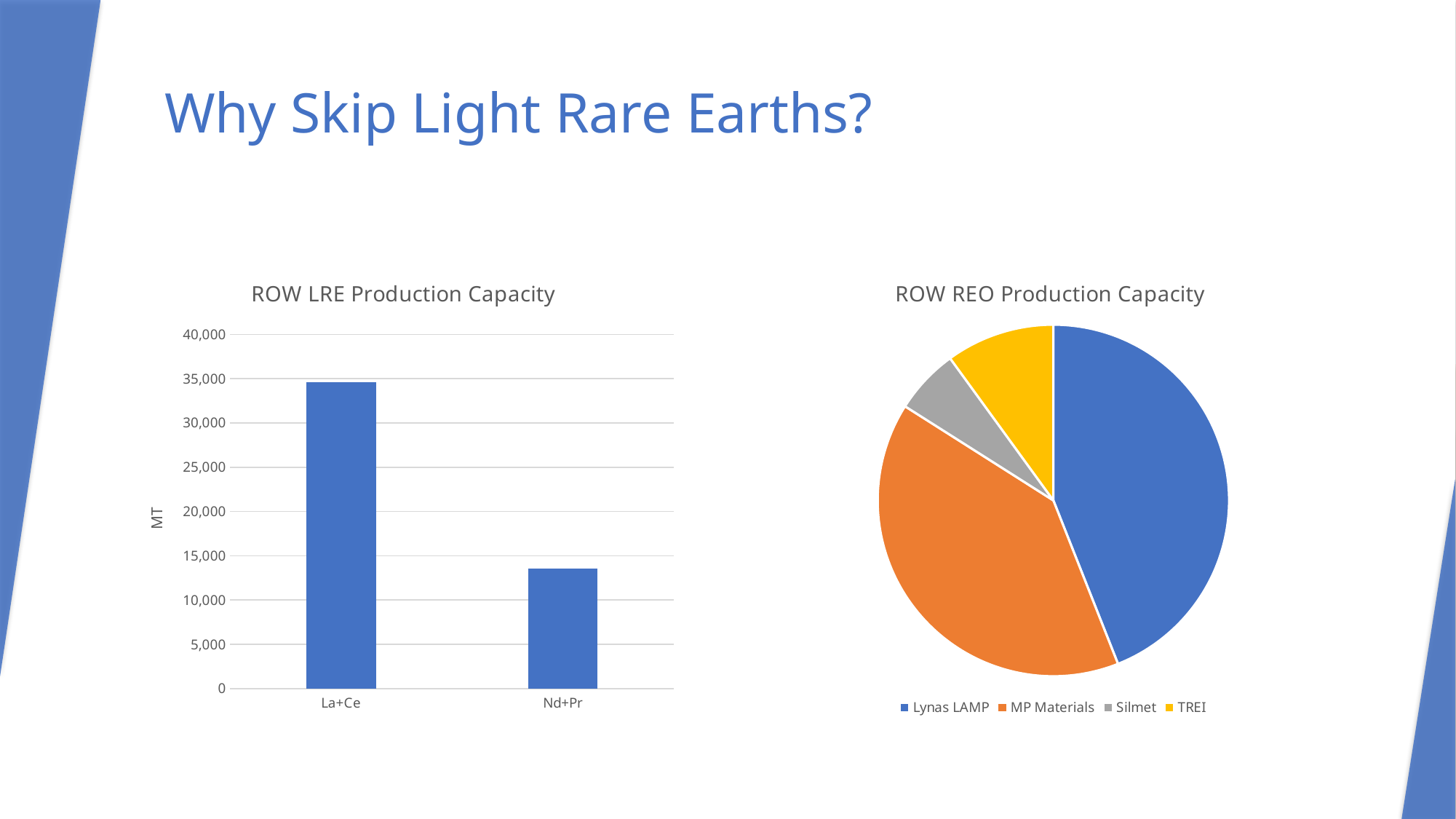
In the 'ROW LRE Production Capacity' chart, which category has the highest value? La+Ce In the 'ROW LRE Production Capacity' chart, which is larger, La+Ce or Nd+Pr? La+Ce What kind of chart is the 'ROW LRE Production Capacity' chart? bar chart In the 'ROW LRE Production Capacity' chart, how many categories are shown on the x axis? 2 In the 'ROW LRE Production Capacity' chart, is the value for La+Ce greater or less than 30,000? greater In the 'ROW REO Production Capacity' chart, which slice is the smallest? Silmet In the 'ROW LRE Production Capacity' chart, is the value for Nd+Pr greater or less than 15,000? less What kind of chart is the 'ROW REO Production Capacity' chart? pie chart In the 'ROW LRE Production Capacity' chart, what is the label on the vertical axis? MT In the 'ROW LRE Production Capacity' chart, which category has the lowest value? Nd+Pr In the 'ROW REO Production Capacity' chart, which slice is the largest? Lynas LAMP In the 'ROW REO Production Capacity' chart, how many entries does the legend list? 4